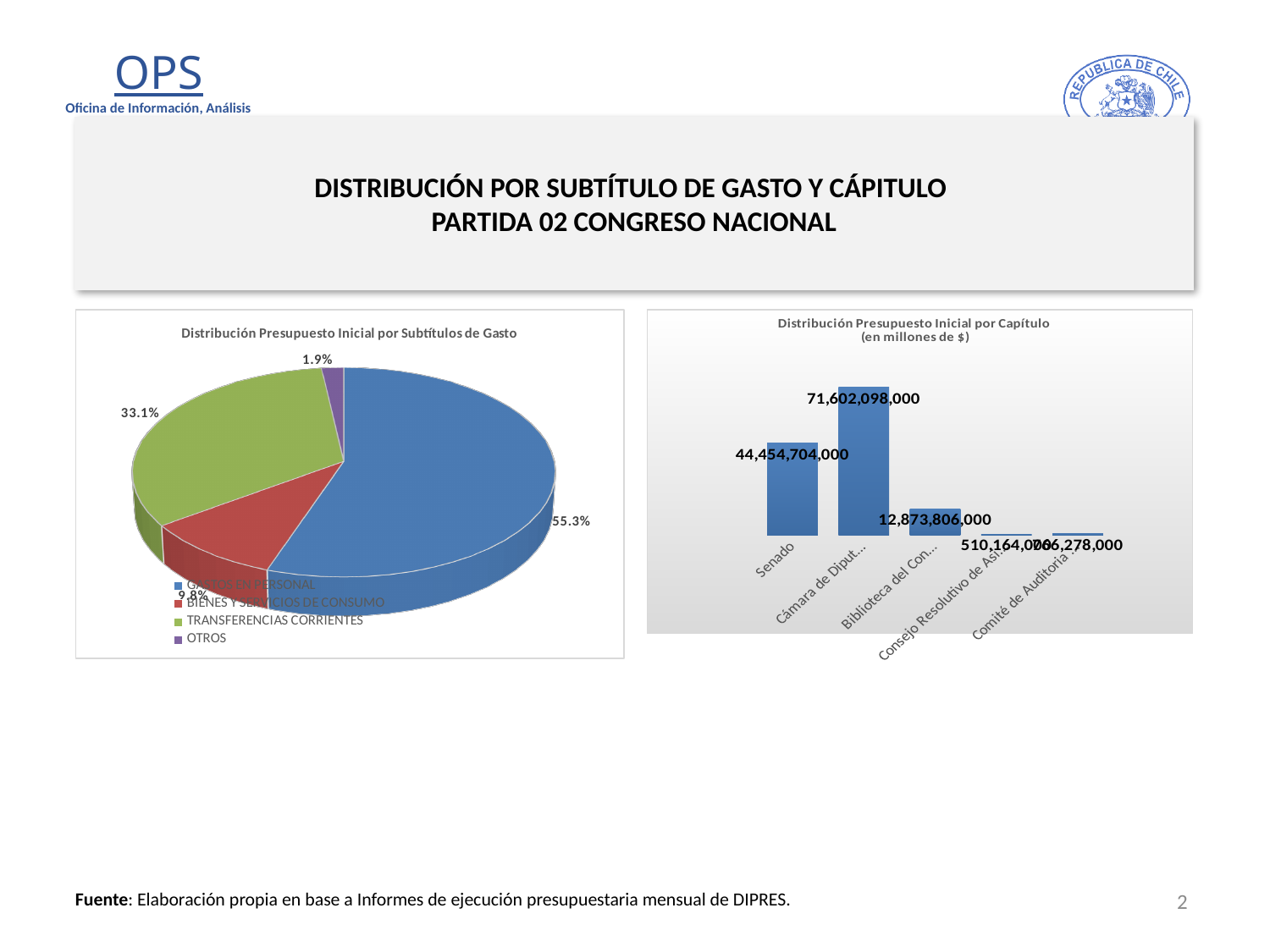
In the pie chart on the left, which category has the smallest slice? OTROS In the pie chart on the left, what percentage is shown for OTROS? 1.9% In the pie chart on the left, what percentage is shown for TRANSFERENCIAS CORRIENTES? 33.1% In the bar chart on the right, what is the difference between the values for Senado and Biblioteca del Con...? 31,580,898,000 In the pie chart on the left, which category has the largest slice? GASTOS EN PERSONAL In the pie chart on the left, how many percentage points larger is GASTOS EN PERSONAL than TRANSFERENCIAS CORRIENTES? 22.2% In the bar chart 'Distribución Presupuesto Inicial por Capítulo', what is the value for Senado? 44,454,704,000 In the bar chart on the right, how many categories are shown? 5 In the bar chart on the right, which category has the highest value? Cámara de Diput... What kind of chart is 'Distribución Presupuesto Inicial por Capítulo'? bar chart In the pie chart 'Distribución Presupuesto Inicial por Subtítulos de Gasto', what share does GASTOS EN PERSONAL have? 55.3% How many entries does the legend of the pie chart on the left list? 4